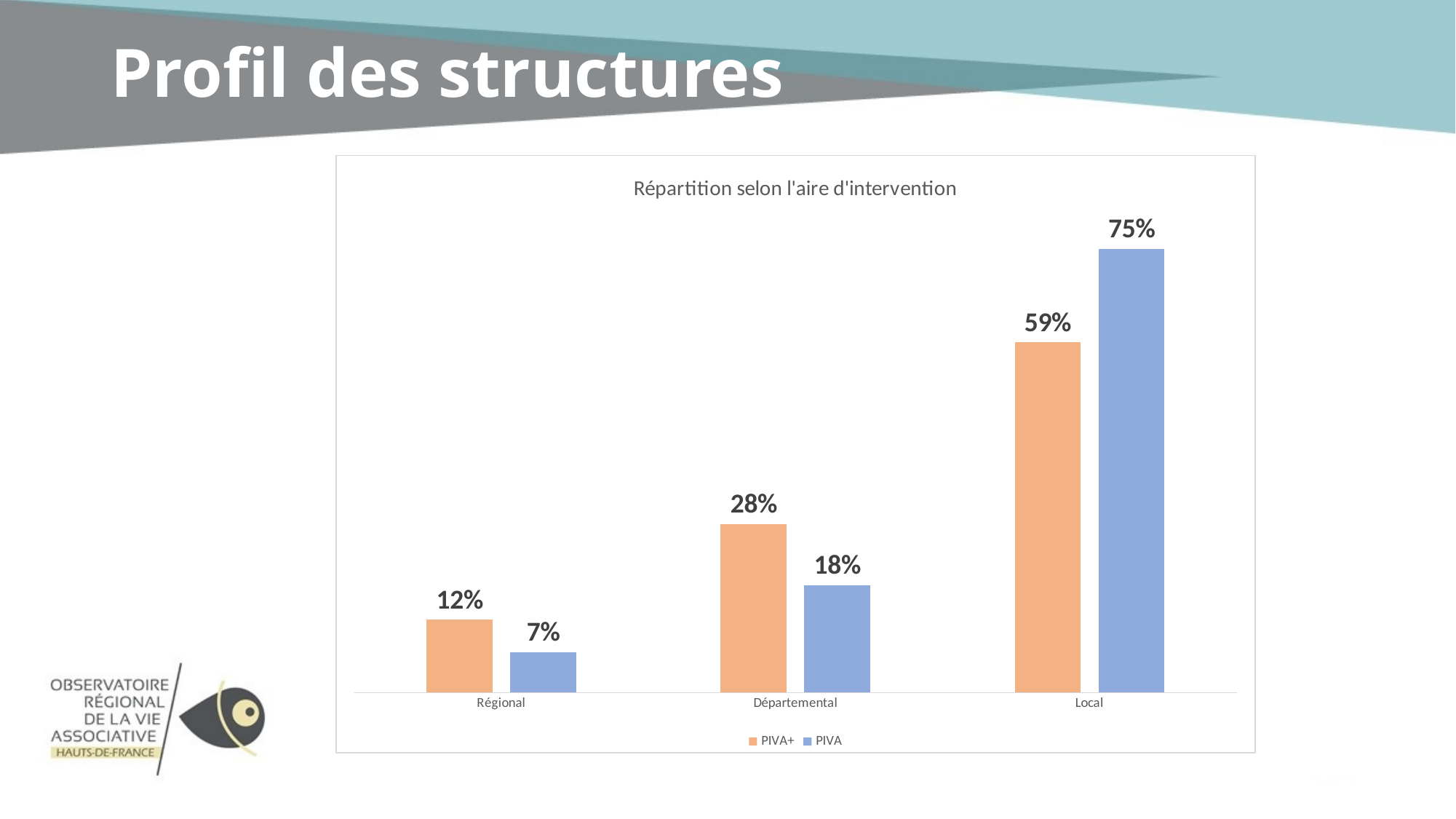
How many series does the legend list? 2 What is the value for PIVA in the Local category? 75% What is the title of the chart? Répartition selon l'aire d'intervention What is the difference between the PIVA+ and PIVA values in the Départemental category? 10% What is the value for PIVA+ in the Régional category? 12% How many categories are shown on the x axis? 3 What kind of chart is shown on the slide? Bar chart Which category has the lowest value for PIVA? Régional What is the difference between the PIVA and PIVA+ values in the Local category? 16% Which is larger in the Régional category, PIVA+ or PIVA? PIVA+ Which category has the highest value for PIVA+? Local What is the value for PIVA in the Départemental category? 18%